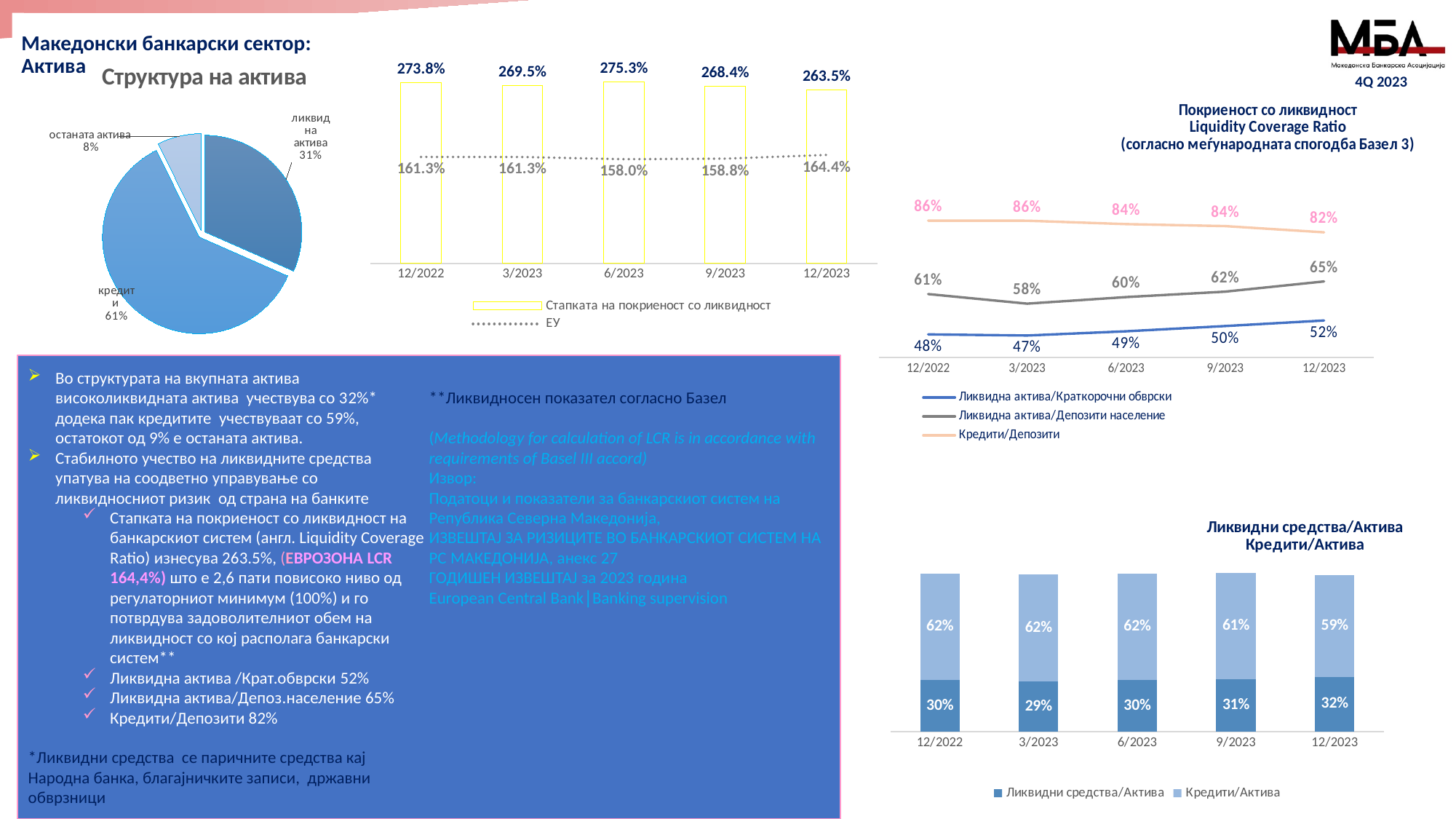
How many slices does the pie chart 'Структура на актива' have? 3 In the pie chart 'Структура на актива', which slice is the smallest? останата актива In the line chart 'Покриеност со ликвидност', does 'Ликвидна актива/Краткорочни обврски' rise or fall from 3/2023 to 12/2023? rise In the bar chart with the yellow bars, what is the difference between the Macedonian liquidity coverage ratio and the ЕУ value for 12/2023? 99.1% In the line chart 'Покриеност со ликвидност', how many series does the legend list? 3 In the stacked bar chart 'Ликвидни средства/Актива Кредити/Актива', which is larger for 9/2023: 'Ликвидни средства/Актива' or 'Кредити/Актива'? Кредити/Актива In the bar chart with the yellow bars, what is the ЕУ value for 6/2023? 158.0% In the stacked bar chart 'Ликвидни средства/Актива Кредити/Актива', what is the total of the bar for 12/2023? 91% In the pie chart 'Структура на актива', what share of assets is 'кредити'? 61% In the line chart 'Покриеност со ликвидност', what is the value of 'Кредити/Депозити' for 12/2023? 82% In the bar chart with the yellow bars (Стапката на покриеност со ликвидност), what is the value for 12/2023? 263.5% In the bar chart with the yellow bars (Стапката на покриеност со ликвидност), which period has the highest value? 6/2023